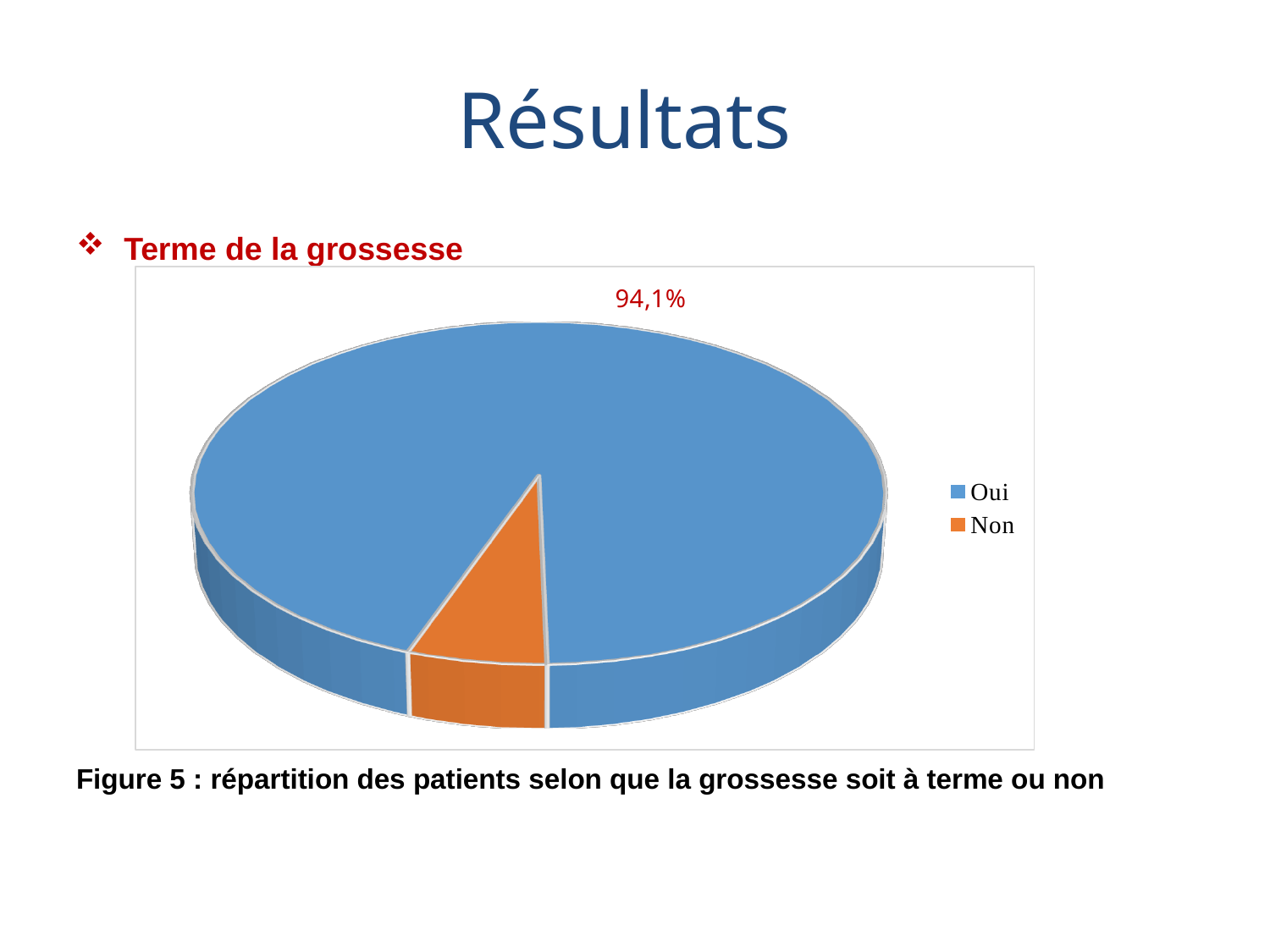
How many entries does the legend of the pie chart list? 2 What is the figure caption below the pie chart? Figure 5 : répartition des patients selon que la grossesse soit à terme ou non How many slices does the pie chart have? 2 Which category has the smallest slice in the pie chart? Non What colour is the "Non" slice in the pie chart? Orange What type of chart is shown on the slide? Pie chart Which slice is larger, "Oui" or "Non"? Oui What percentage is shown for the "Oui" slice of the pie chart? 94,1% What share of the pie does the "Oui" slice represent? 94,1% Which category has the largest slice in the pie chart? Oui